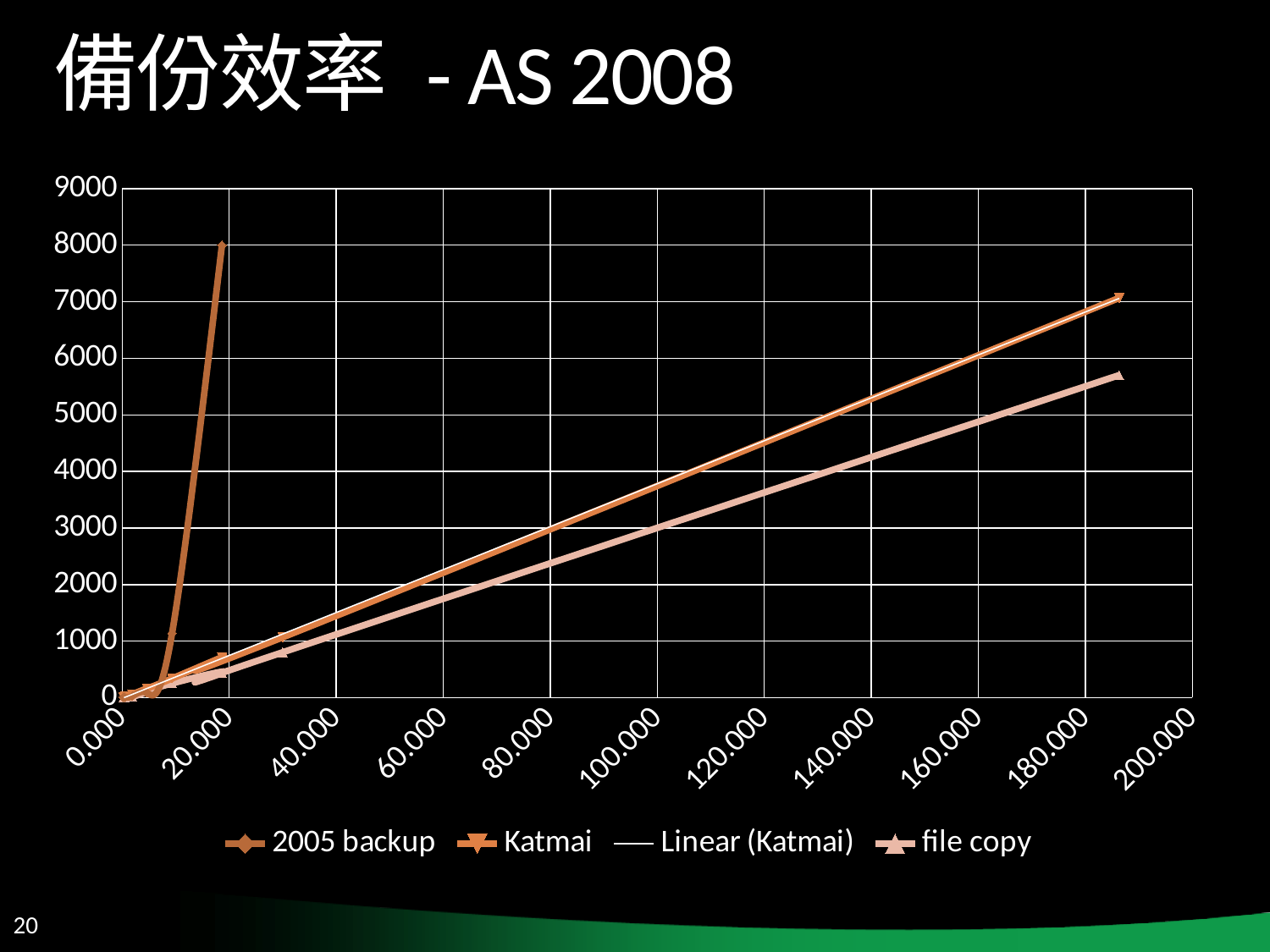
Do the values of the file copy series rise or fall as the x-axis increases? rise How many series does the legend list? 4 What are the series names listed in the legend? 2005 backup, Katmai, Linear (Katmai), file copy What is the maximum value shown on the vertical axis? 9000 Which series reaches the highest value on the chart? 2005 backup Do the values of the Katmai series rise or fall as the x-axis increases? rise What kind of chart is shown on the slide? line chart Is the highest value reached by the Katmai series greater or less than 6000? greater Is the highest value reached by the 2005 backup series greater or less than 7000? greater Is the highest value reached by the file copy series greater or less than 6000? less At the right end of the chart, which series is higher: Katmai or file copy? Katmai What is the title of the slide containing the chart? 備份效率 - AS 2008